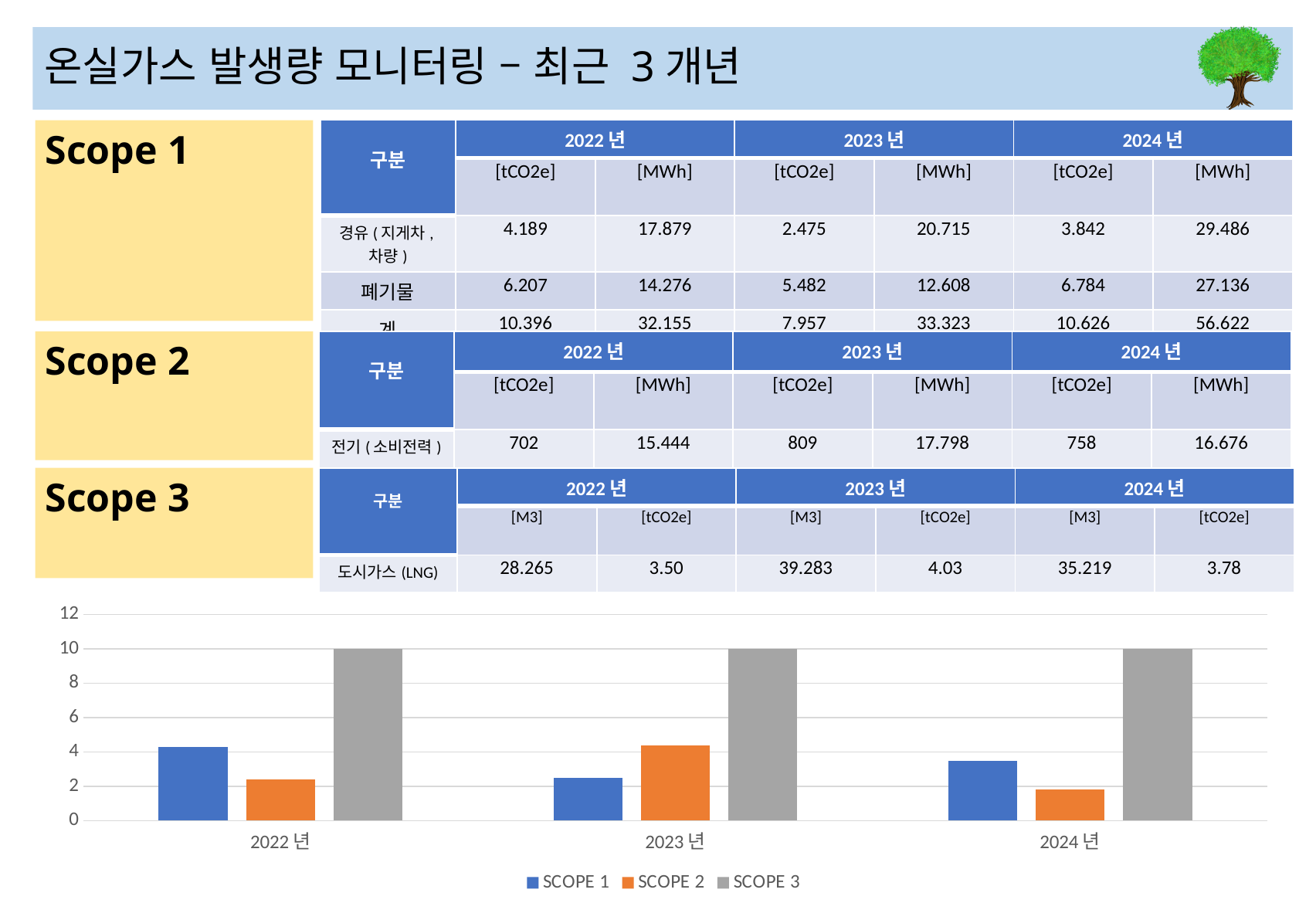
Is the value for SCOPE 2 in 2024 년 greater or less than 2? less Which series has the highest bar for 2023 년 in the chart? SCOPE 3 What colour are the SCOPE 3 bars in the chart? grey In 2023 년, which is larger in the chart: SCOPE 1 or SCOPE 2? SCOPE 2 Is the value for SCOPE 1 in 2022 년 greater or less than 4? greater What is the value of the SCOPE 3 bar for 2022 년 in the chart? 10 What kind of chart is shown at the bottom of the slide? bar chart What is the value of the SCOPE 3 bar for 2024 년 in the chart? 10 How many series does the chart legend list? 3 In 2022 년, which is larger in the chart: SCOPE 1 or SCOPE 2? SCOPE 1 How many year categories are shown on the x axis of the chart? 3 Which series has the lowest bar for 2024 년 in the chart? SCOPE 2